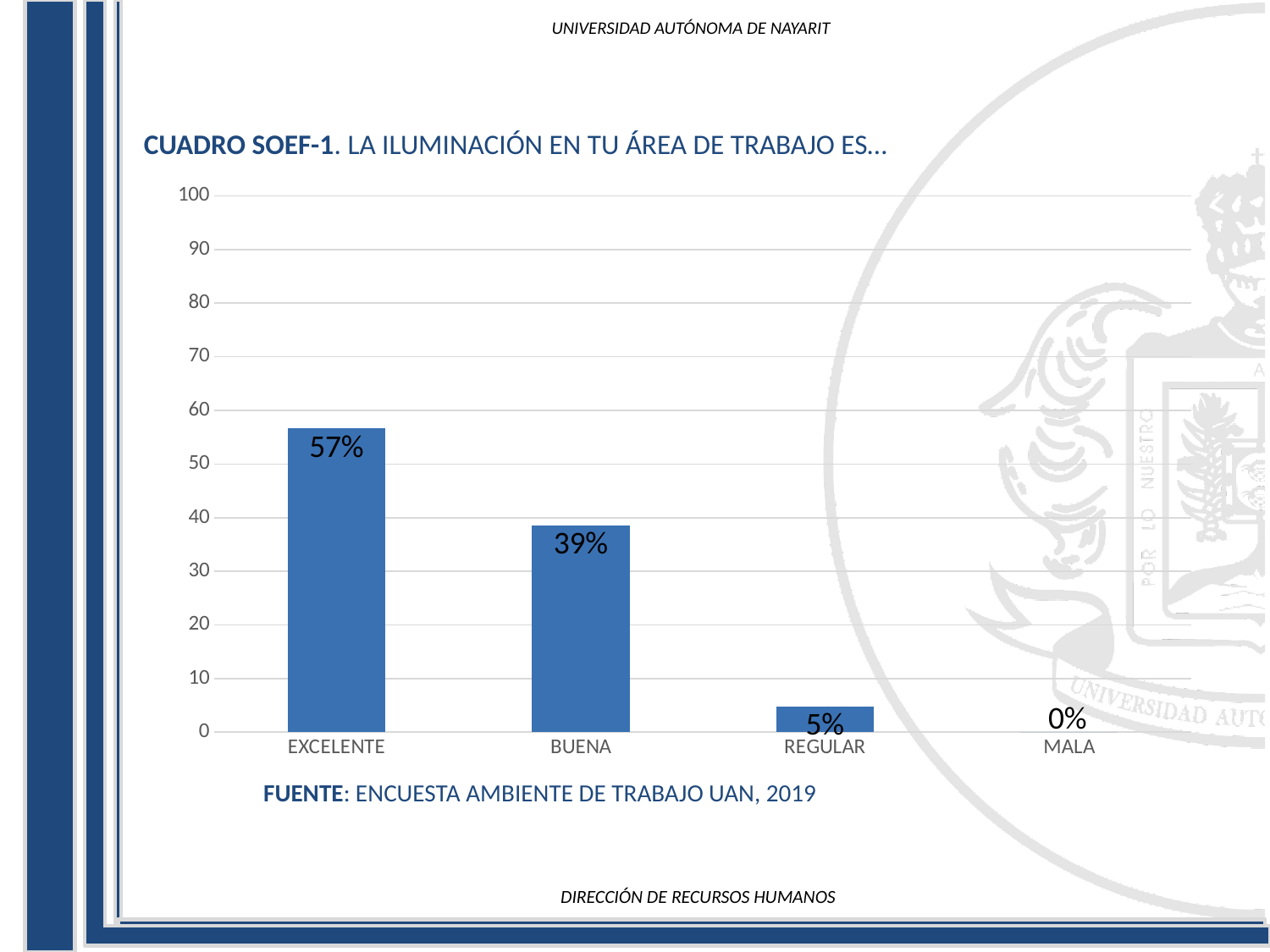
Which category has the highest value? EXCELENTE Which is larger, the value for BUENA or the value for REGULAR? BUENA What is the value for MALA? 0% What is the value for EXCELENTE? 57% What is the difference between the values for EXCELENTE and BUENA? 18% How many categories are shown on the x axis? 4 What kind of chart is shown on the slide? bar chart What is the value for REGULAR? 5% What is the source cited below the chart? ENCUESTA AMBIENTE DE TRABAJO UAN, 2019 Is the value for EXCELENTE greater or less than 50? greater Which category has the lowest value? MALA What is the value for BUENA? 39%